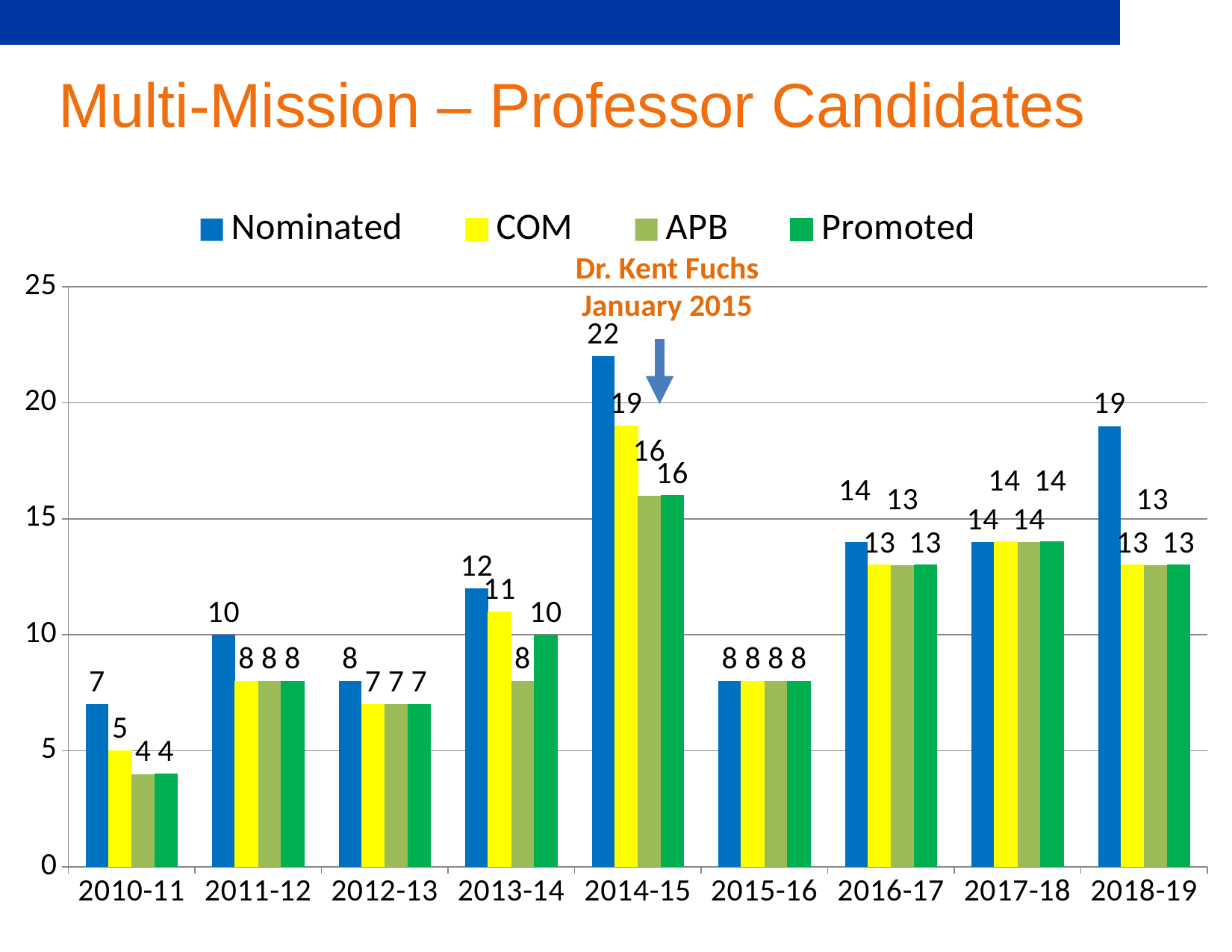
What is the Nominated value for 2014-15? 22 What kind of chart is shown on the slide? bar chart What is the Promoted value for 2010-11? 4 Which year has the highest Nominated value? 2014-15 What is the difference between the Nominated and Promoted values for 2018-19? 6 Which year has the lowest Promoted value? 2010-11 How many academic years are shown on the x axis? 9 Which is larger, the Nominated value for 2013-14 or the Nominated value for 2016-17? 2016-17 Is the Nominated value for 2014-15 greater or less than 20? greater What annotation text appears above the 2014-15 bars? Dr. Kent Fuchs January 2015 What is the COM value for 2013-14? 11 How many series does the legend list? 4